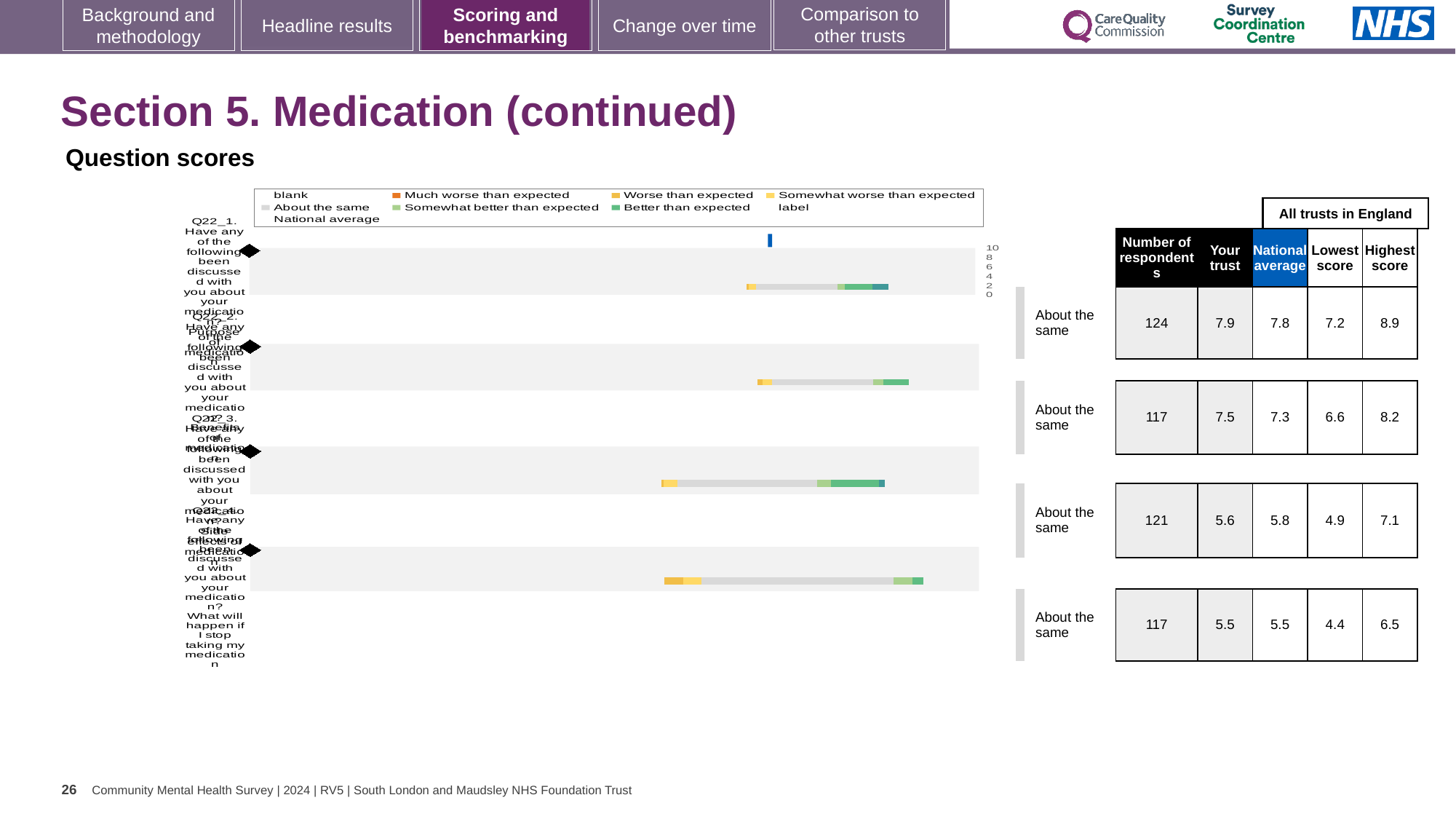
How many question rows (Q22_1 to Q22_4) are plotted in the chart? 4 Which question has the highest 'Your trust' score in the table beside the chart? Q22_1 What kind of chart is shown on the slide? bar chart For Q22_1, what is the difference between the Highest score and the Lowest score in the table? 1.7 For Q22_2, which is larger: the 'Your trust' score or the National average? Your trust In the table beside the chart, what is the 'Your trust' score for Q22_1? 7.9 In the chart legend, what colour represents 'About the same'? grey Which question has the lowest 'Your trust' score in the table beside the chart? Q22_4 In the table beside the chart, what is the National average score for Q22_3? 5.8 What is the highest value shown on the chart's numeric axis? 10 What benchmark category is shown for each of the four questions next to the chart? About the same In the table beside the chart, how many respondents answered Q22_3? 121